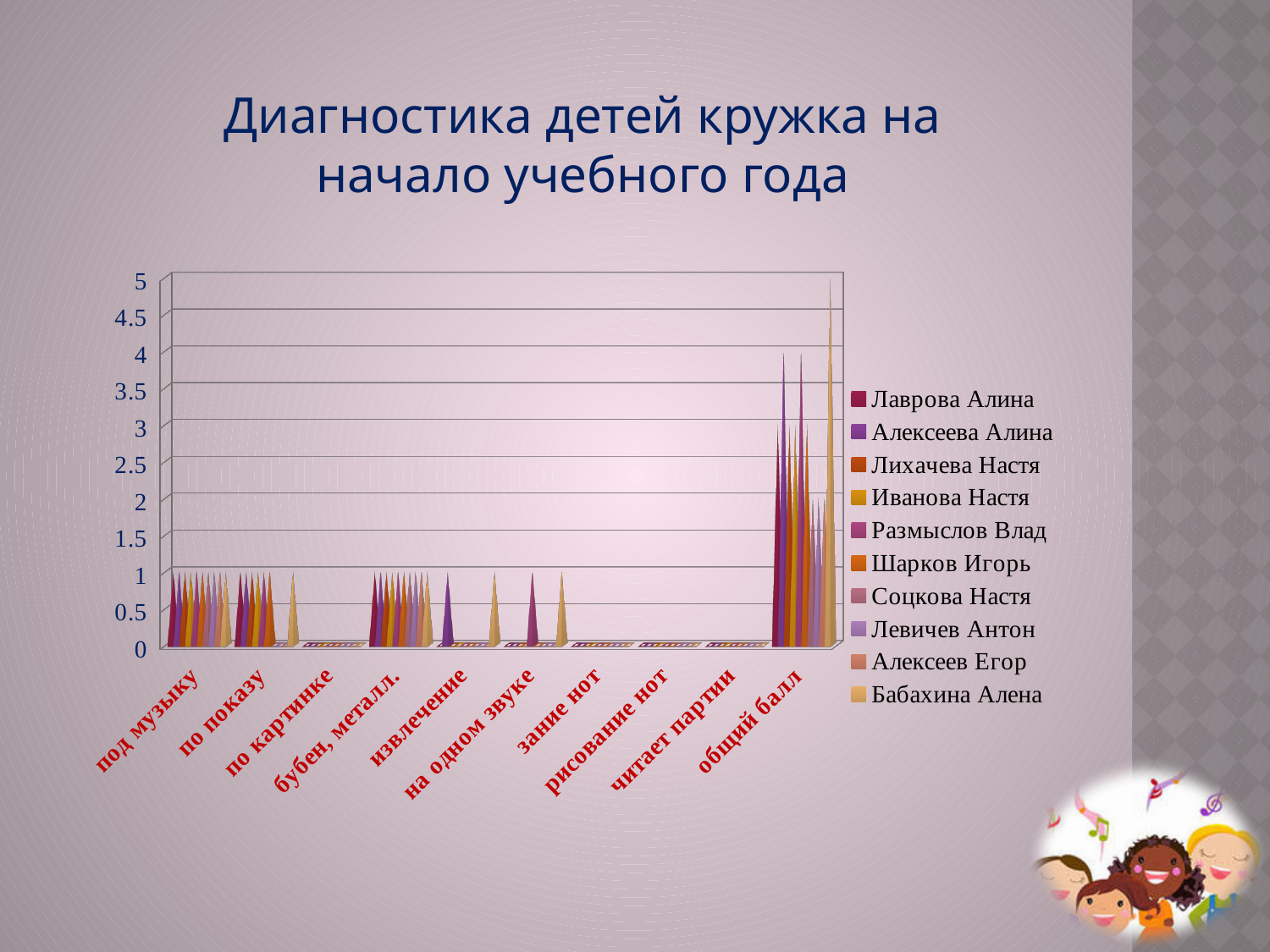
How many categories are shown along the x axis of the chart? 10 How many series does the chart legend list? 10 What is the title of the slide containing the chart? Диагностика детей кружка на начало учебного года What is the highest value shown on the vertical axis of the chart? 5 Is the value for Бабахина Алена in 'общий балл' greater or less than 4? greater In the category 'общий балл', which series has the highest value? Бабахина Алена Is the value for Лаврова Алина in 'общий балл' greater or less than 2? greater In 'общий балл', which is larger: the value for Бабахина Алена or the value for Лаврова Алина? Бабахина Алена Is the value for Бабахина Алена in 'на одном звуке' greater or less than 1.5? less What kind of chart is shown on the slide? bar chart Which category has the tallest bars in the chart? общий балл